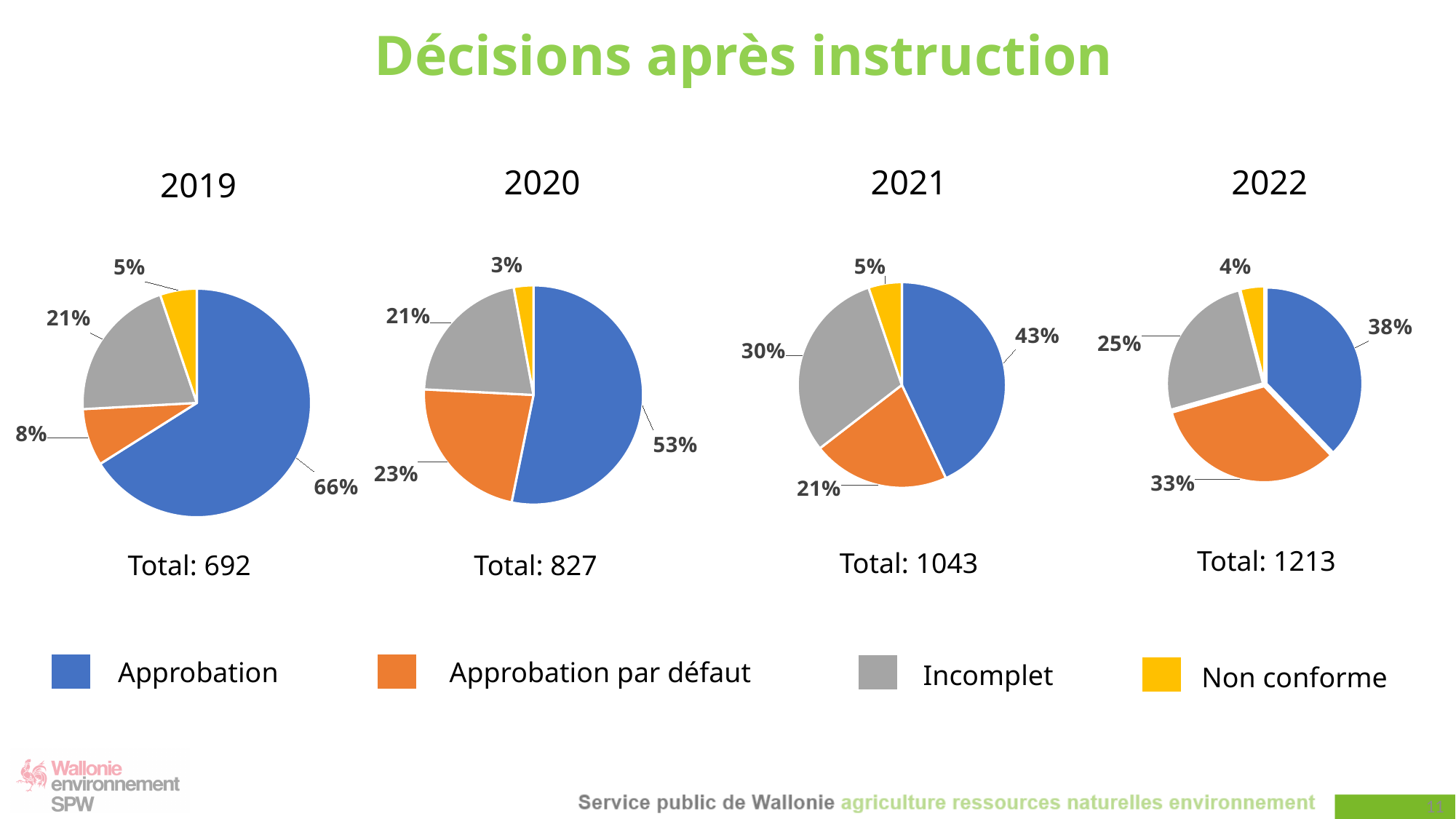
In the 2020 pie chart, what share is Approbation par défaut? 23% In the 2021 pie chart, which is larger: Approbation par défaut or Incomplet? Incomplet In the 2021 pie chart, what share is Incomplet? 30% In the 2022 pie chart, which category has the largest slice? Approbation In the 2022 pie chart, what share is Non conforme? 4% In the 2019 pie chart, what is the difference between the Approbation share and the Incomplet share? 45% What kind of chart is used for each year on the slide? Pie chart In the 2020 pie chart, which category has the smallest slice? Non conforme How many categories does the legend list? 4 How many pie charts are on the slide? 4 What is the total shown under the 2021 pie chart? 1043